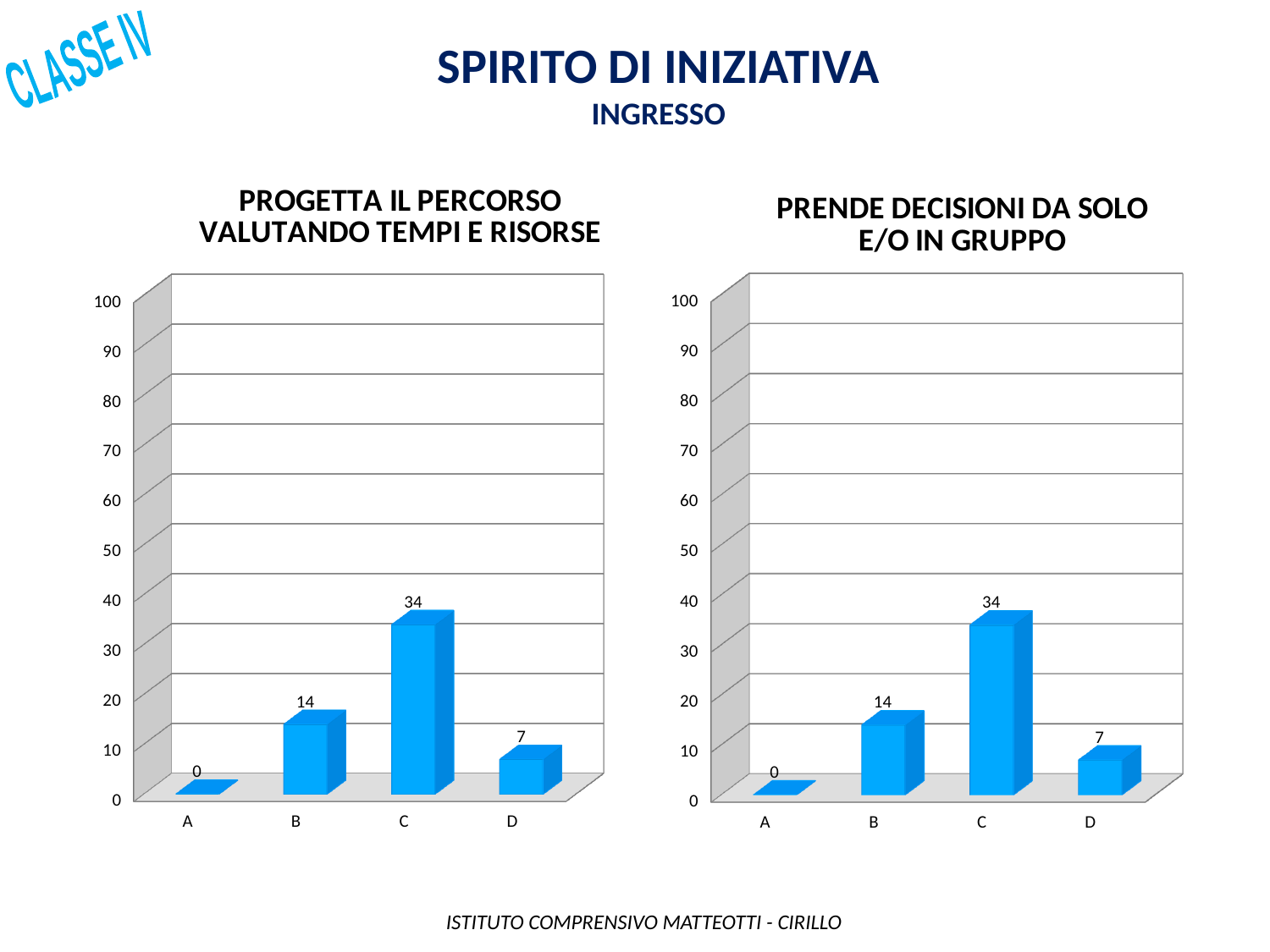
In the chart titled 'PROGETTA IL PERCORSO VALUTANDO TEMPI E RISORSE', what is the value for category C? 34 In the chart titled 'PROGETTA IL PERCORSO VALUTANDO TEMPI E RISORSE', which category has the highest value? C In the chart titled 'PROGETTA IL PERCORSO VALUTANDO TEMPI E RISORSE', what is the value for category B? 14 In the chart titled 'PRENDE DECISIONI DA SOLO E/O IN GRUPPO', what is the value for category D? 7 In the chart titled 'PRENDE DECISIONI DA SOLO E/O IN GRUPPO', which is larger, the value for B or the value for D? B In the chart titled 'PRENDE DECISIONI DA SOLO E/O IN GRUPPO', what is the value for category A? 0 How many categories are shown in the chart titled 'PRENDE DECISIONI DA SOLO E/O IN GRUPPO'? 4 In the chart titled 'PROGETTA IL PERCORSO VALUTANDO TEMPI E RISORSE', what is the difference between the values for C and B? 20 How many charts are shown on the slide? 2 In the chart titled 'PROGETTA IL PERCORSO VALUTANDO TEMPI E RISORSE', is the value for C greater or less than 50? less What kind of chart is the chart titled 'PROGETTA IL PERCORSO VALUTANDO TEMPI E RISORSE'? bar chart In the chart titled 'PRENDE DECISIONI DA SOLO E/O IN GRUPPO', which category has the lowest value? A